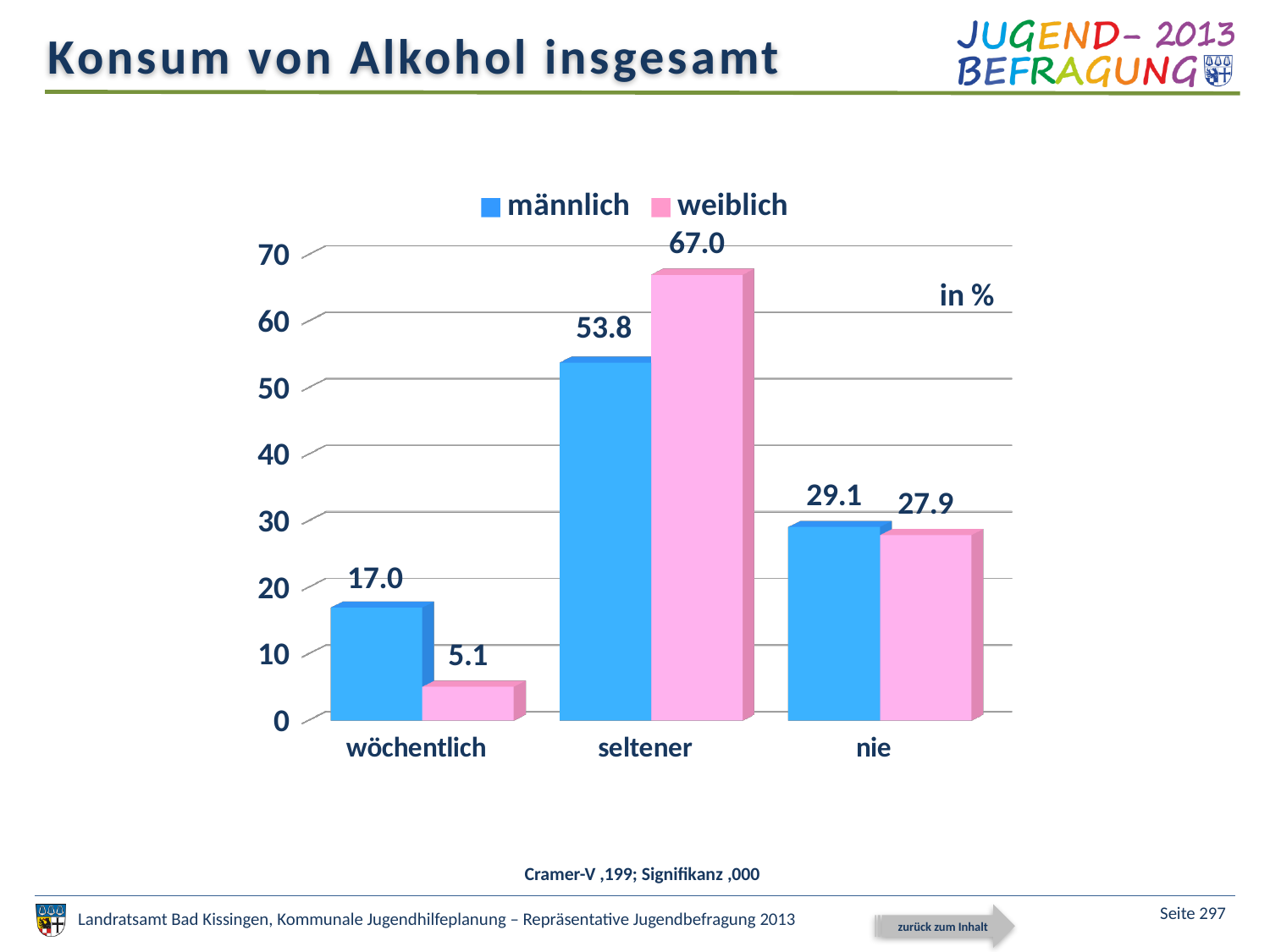
What is the value for männlich in the nie category? 29.1 Which category has the highest value for weiblich? seltener What is the value for weiblich in the seltener category? 67.0 What is the title of the slide? Konsum von Alkohol insgesamt Which category has the lowest value for männlich? wöchentlich In the wöchentlich category, which is larger: männlich or weiblich? männlich What kind of chart is shown on the slide? bar chart What is the difference between the weiblich and männlich values in the seltener category? 13.2 How many series does the legend list? 2 What is the value for weiblich in the wöchentlich category? 5.1 How many categories are shown on the x axis? 3 What is the value for männlich in the wöchentlich category? 17.0